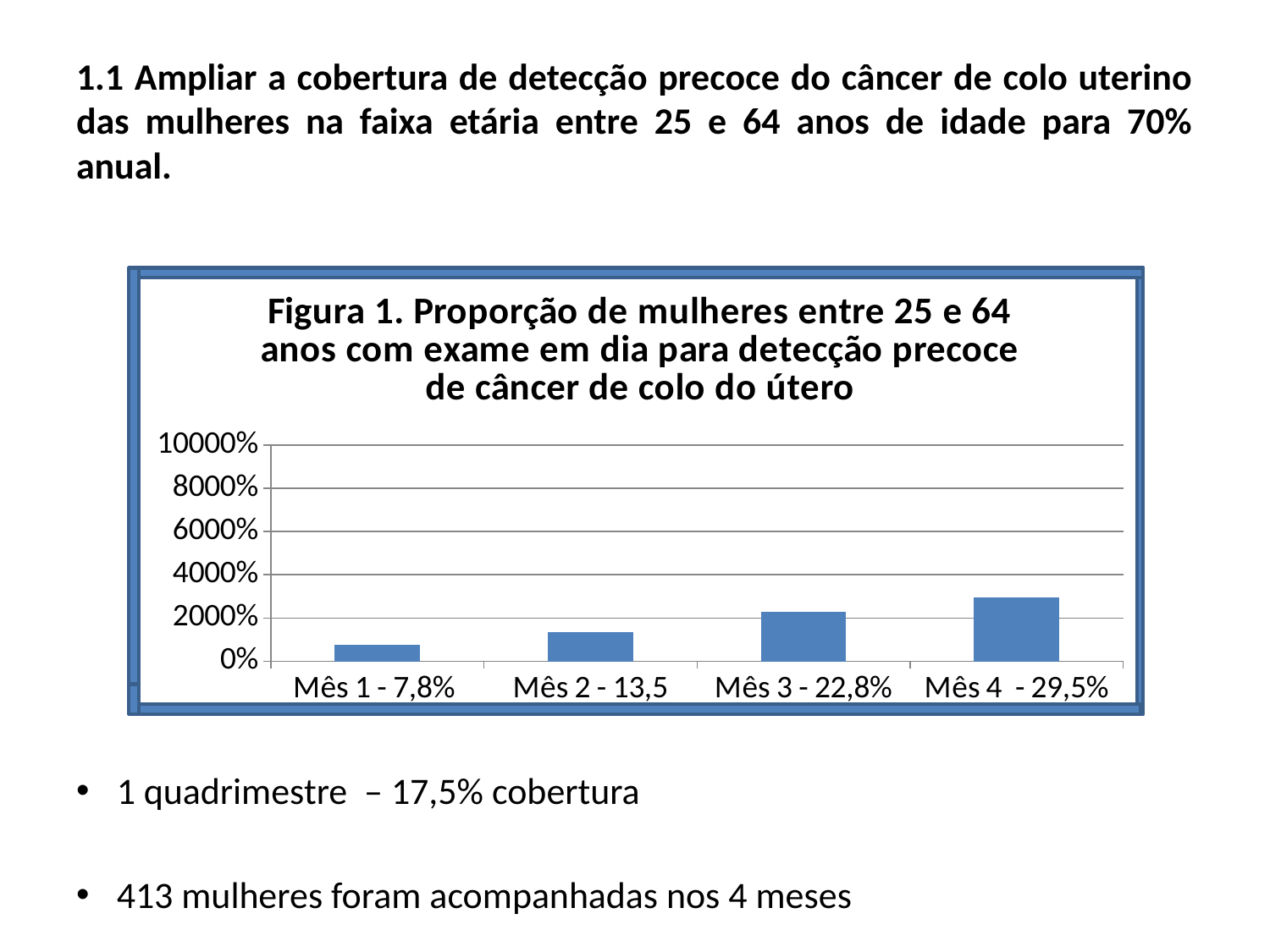
Which category has the shortest bar in Figura 1? Mês 1 - 7,8% Which bar is taller in Figura 1, Mês 2 or Mês 3? Mês 3 How many bars (categories) are plotted in Figura 1? 4 Is the bar for Mês 4 in Figura 1 greater or less than 2000%? greater What type of chart is shown in Figura 1? bar chart What percentage is written in the category label for Mês 1 in Figura 1? 7,8% What percentage is written in the category label for Mês 3 in Figura 1? 22,8% Is the bar for Mês 4 in Figura 1 greater or less than 4000%? less Do the bar values in Figura 1 rise or fall from Mês 1 to Mês 4? rise What is the highest value shown on the vertical axis of Figura 1? 10000% Is the bar for Mês 1 in Figura 1 greater or less than 2000%? less Which category has the tallest bar in Figura 1? Mês 4 - 29,5%